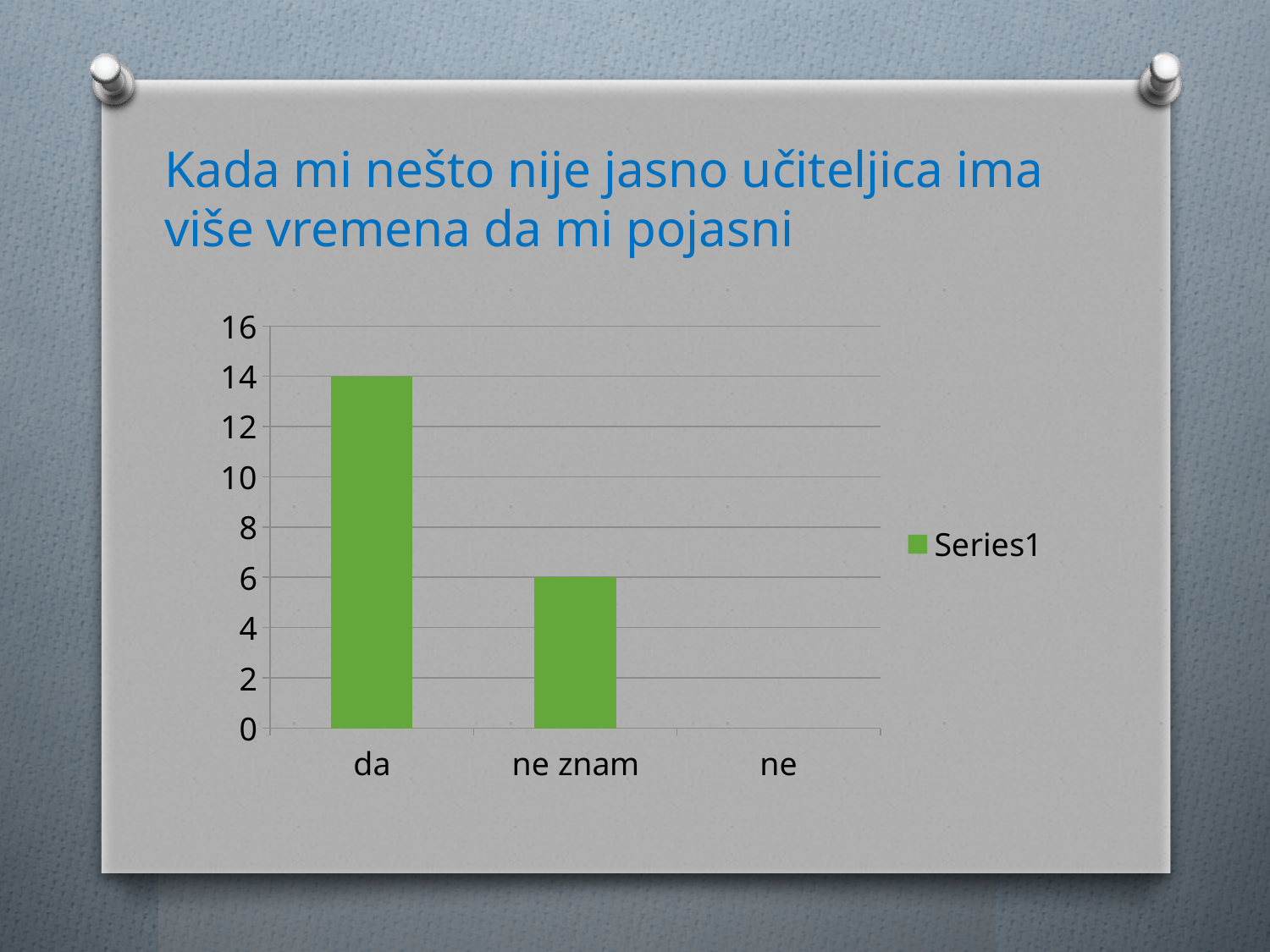
What is the value for "ne"? 0 What is the difference between the values for "da" and "ne znam"? 8 Which category has the lowest value? ne What is the name of the series shown in the legend? Series1 How many categories are shown on the x axis of the chart? 3 What is the value for "da"? 14 Which is larger, the value for "da" or the value for "ne znam"? da How many series does the legend list? 1 What type of chart is shown on the slide? bar chart Is the value for "ne znam" greater or less than 10? less What is the value for "ne znam"? 6 Which category has the highest value? da